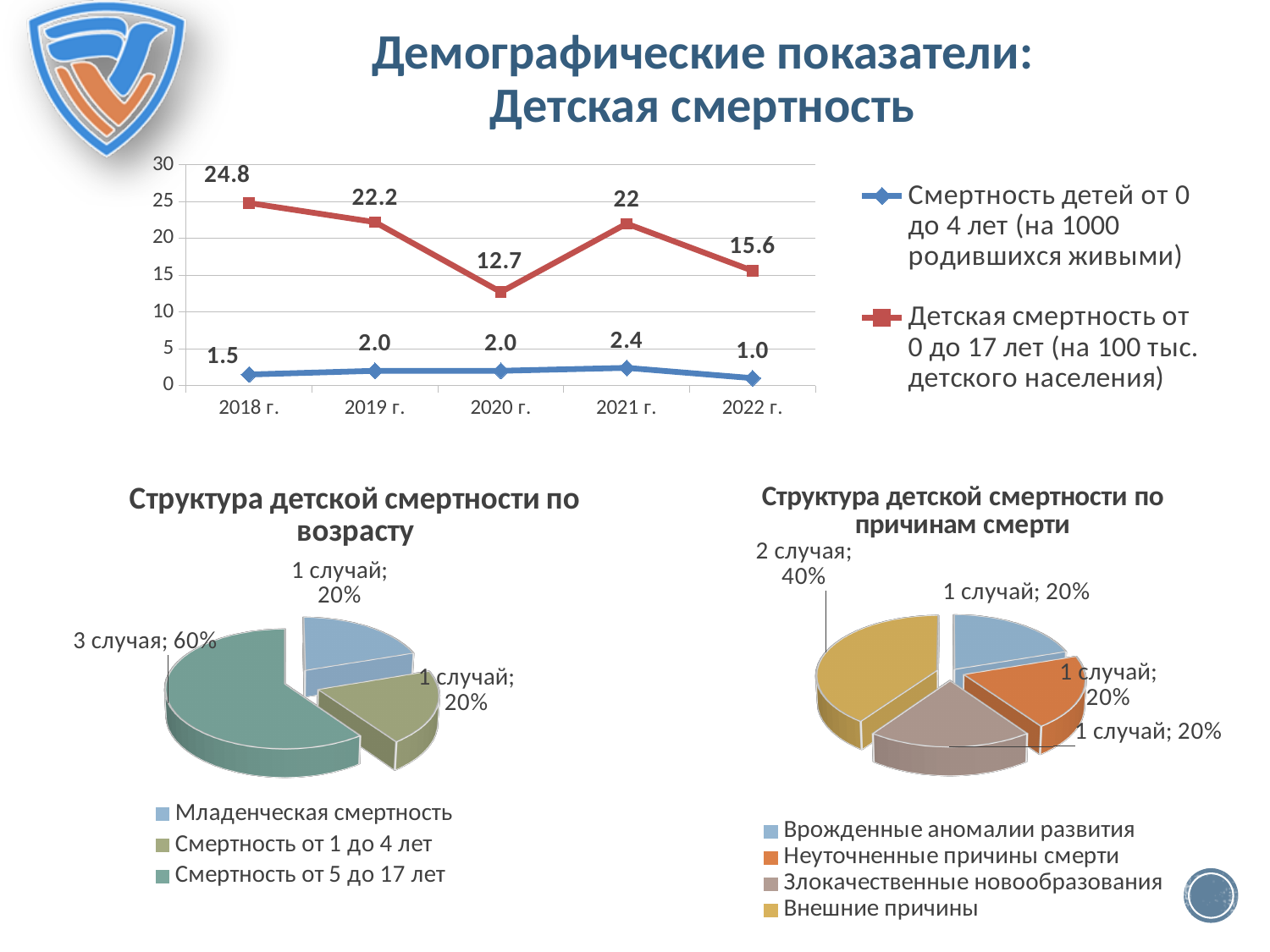
На верхнем линейном графике какое значение детской смертности от 0 до 17 лет (на 100 тыс. детского населения) указано за 2018 г.? 24.8 На диаграмме «Структура детской смертности по причинам смерти» какая причина имеет наибольшую долю? Внешние причины На верхнем линейном графике в каком году смертность детей от 0 до 4 лет была наибольшей? 2021 г. На диаграмме «Структура детской смертности по возрасту» какую долю составляет смертность от 5 до 17 лет? 60% На диаграмме «Структура детской смертности по причинам смерти» сколько категорий указано в легенде? 4 На диаграмме «Структура детской смертности по возрасту» сколько случаев приходится на младенческую смертность? 1 случай На верхнем линейном графике какое значение смертности детей от 0 до 4 лет (на 1000 родившихся живыми) указано за 2021 г.? 2.4 На верхнем линейном графике на сколько снизилась детская смертность от 0 до 17 лет с 2021 г. по 2022 г.? 6.4 На верхнем линейном графике сколько рядов данных указано в легенде? 2 На верхнем линейном графике сколько лет (точек по оси x) показано? 5 На верхнем линейном графике в каком году детская смертность от 0 до 17 лет была наименьшей? 2020 г. Какого типа верхняя диаграмма на слайде? Линейный график